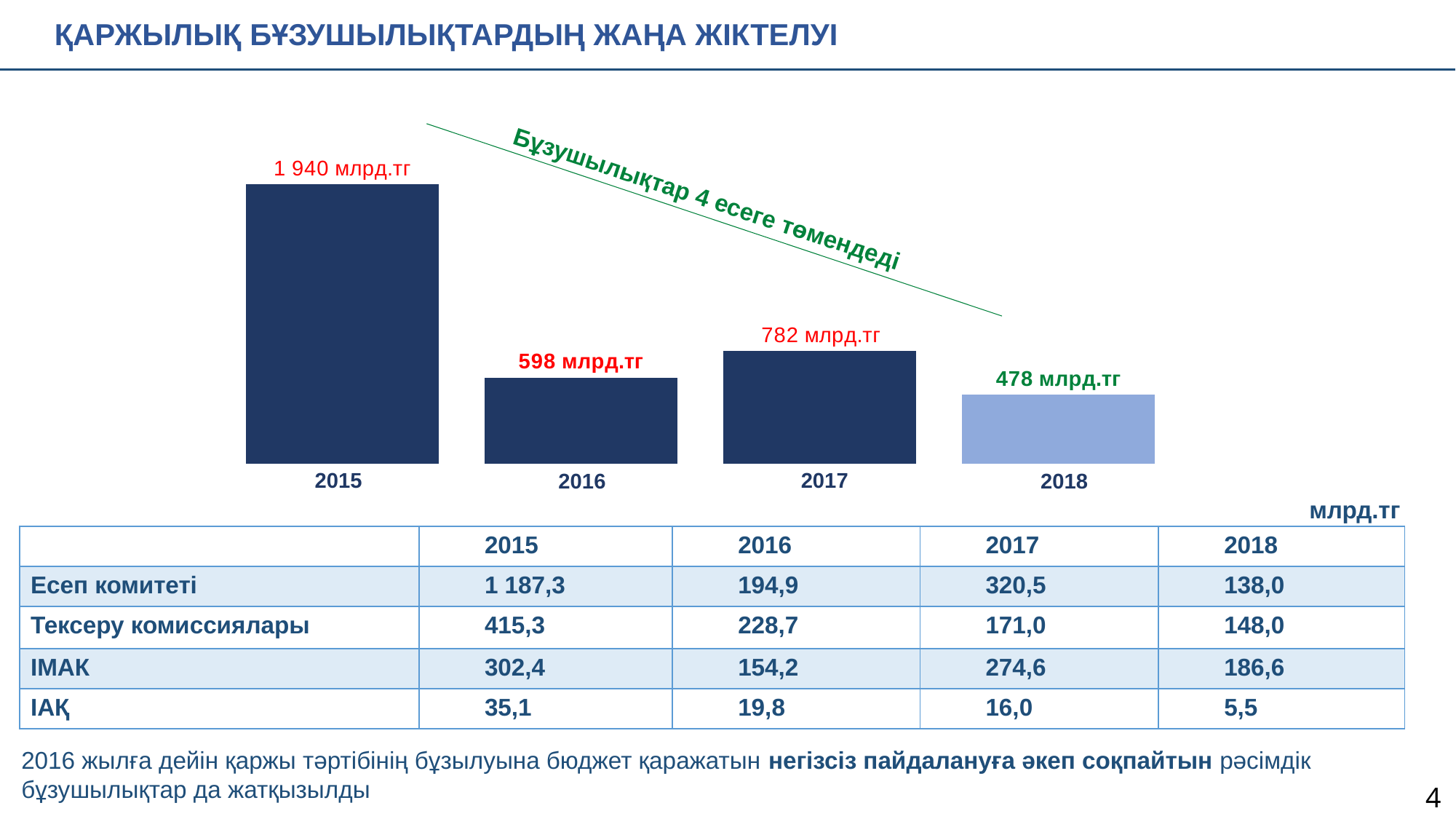
Which bar in the chart is drawn in a lighter blue colour than the others? 2018 Which year has the highest value in the bar chart? 2015 What is the value shown for 2016 in the bar chart? 598 млрд.тг Which is larger in the bar chart, the value for 2016 or the value for 2017? 2017 What is the value shown for 2017 in the bar chart? 782 млрд.тг Which year has the lowest value in the bar chart? 2018 What is the difference between the 2015 and 2018 values in the bar chart? 1 462 млрд.тг What is the difference between the 2017 and 2016 values in the bar chart? 184 млрд.тг How many bars are shown in the bar chart? 4 What is the value shown for 2015 in the bar chart? 1 940 млрд.тг What type of chart is shown on the slide? Bar chart What is the value shown for 2018 in the bar chart? 478 млрд.тг